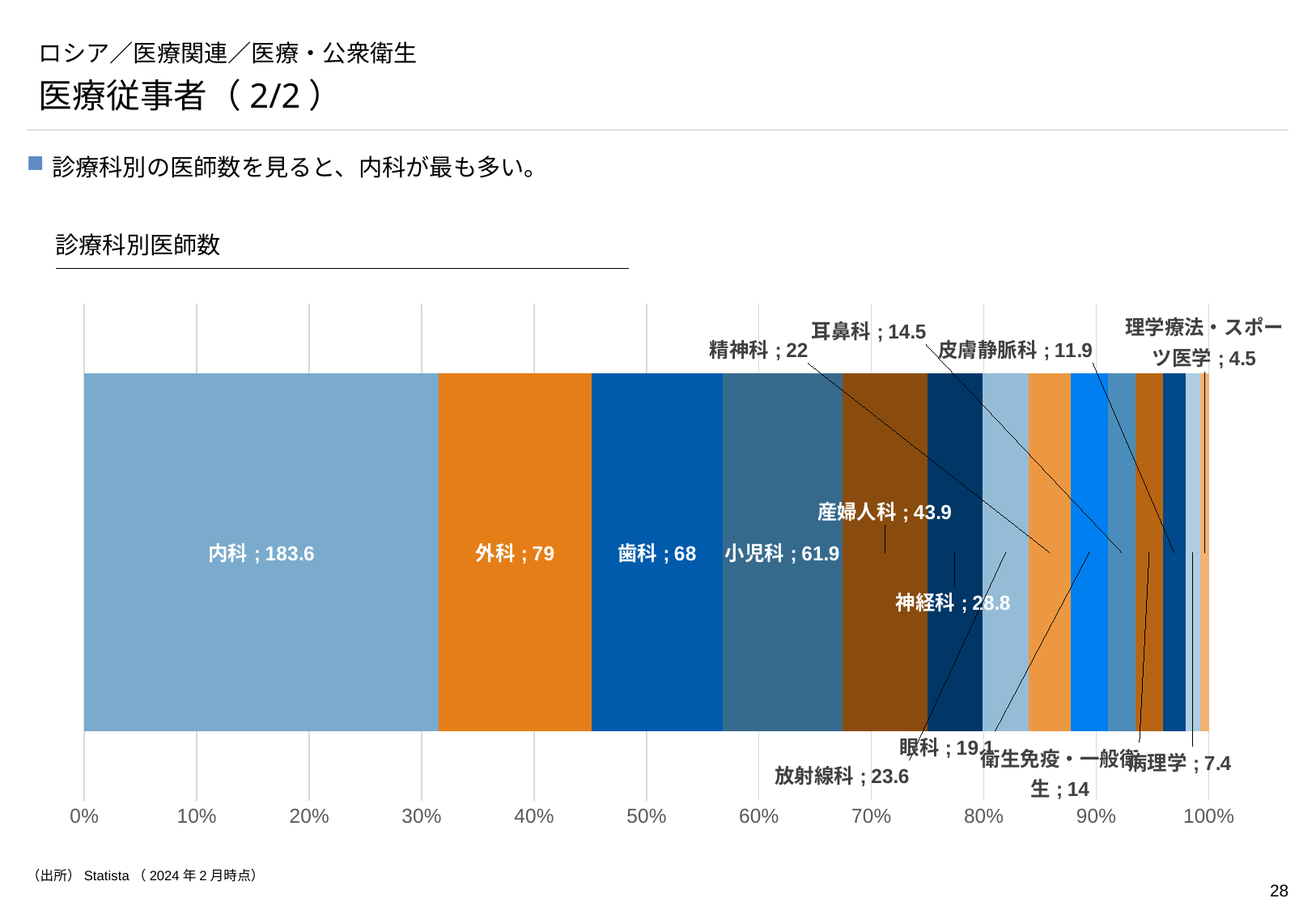
Which has a larger value in the 診療科別医師数 chart, 歯科 or 小児科? 歯科 What is the value for 外科 in the 診療科別医師数 chart? 79 What is the value for 小児科 in the 診療科別医師数 chart? 61.9 What is the difference between the values for 内科 and 外科 in the 診療科別医師数 chart? 104.6 Which department has the lowest value in the 診療科別医師数 chart? 理学療法・スポーツ医学 What kind of chart is the 診療科別医師数 chart? Stacked bar chart What is the value for 神経科 in the 診療科別医師数 chart? 28.8 Which department has the highest value in the 診療科別医師数 chart? 内科 How many departments (segments) are shown in the 診療科別医師数 chart? 14 What is the value for 理学療法・スポーツ医学 in the 診療科別医師数 chart? 4.5 What is the value for 内科 in the 診療科別医師数 chart? 183.6 What is the title of the chart on the slide? 診療科別医師数